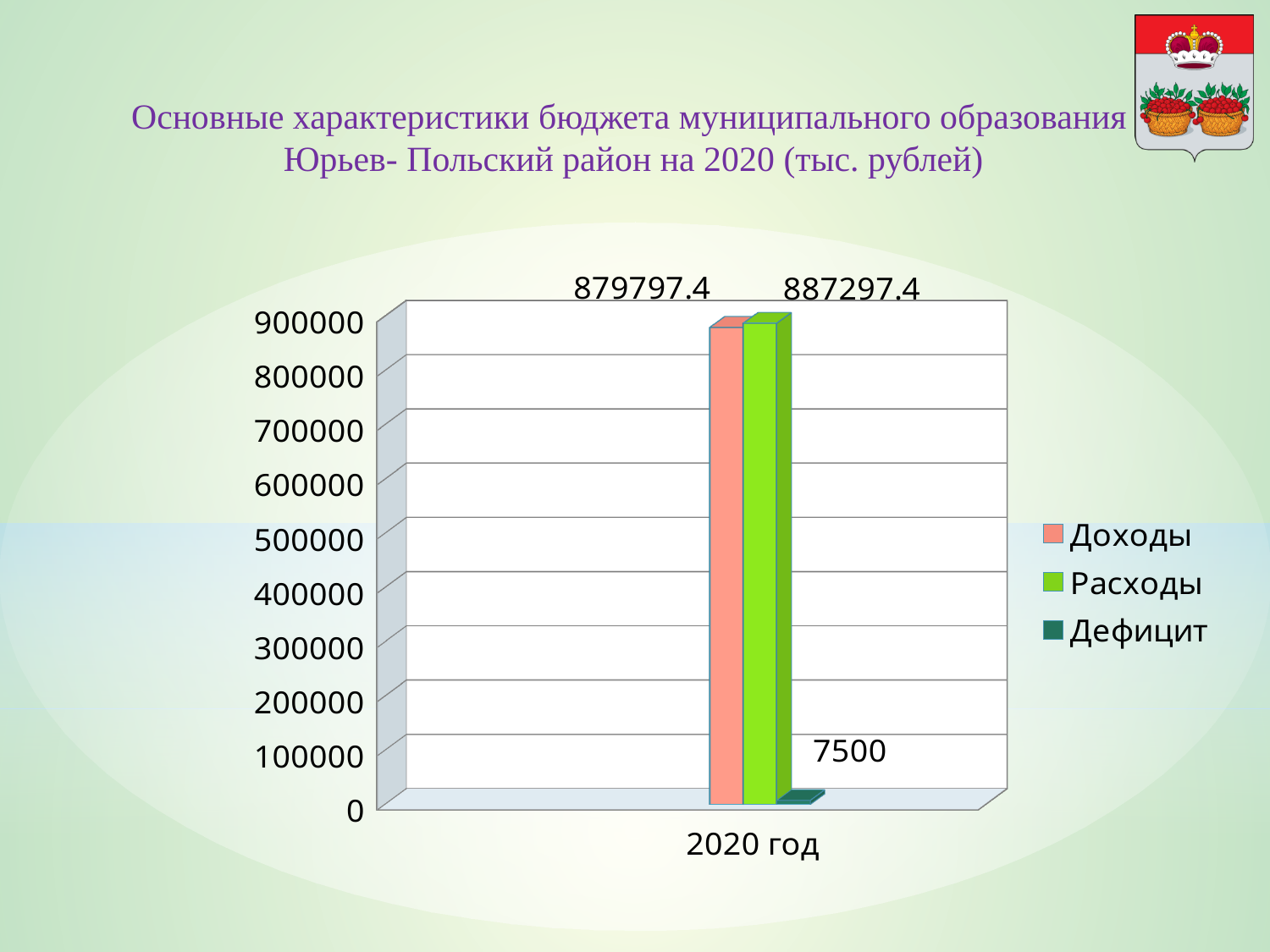
Which series has the lowest value in 2020 год? Дефицит What kind of chart is shown on the slide? bar chart What is the value of Расходы for 2020 год? 887297.4 Which is larger for 2020 год, Доходы or Расходы? Расходы How many series does the legend list? 3 What is the value of Дефицит for 2020 год? 7500 What is the value of Доходы for 2020 год? 879797.4 Which series has the highest value in 2020 год? Расходы Is the value for Доходы greater or less than 800000? greater What is the difference between Расходы and Доходы for 2020 год? 7500 What category label is shown on the x axis? 2020 год Is the value for Дефицит greater or less than 100000? less